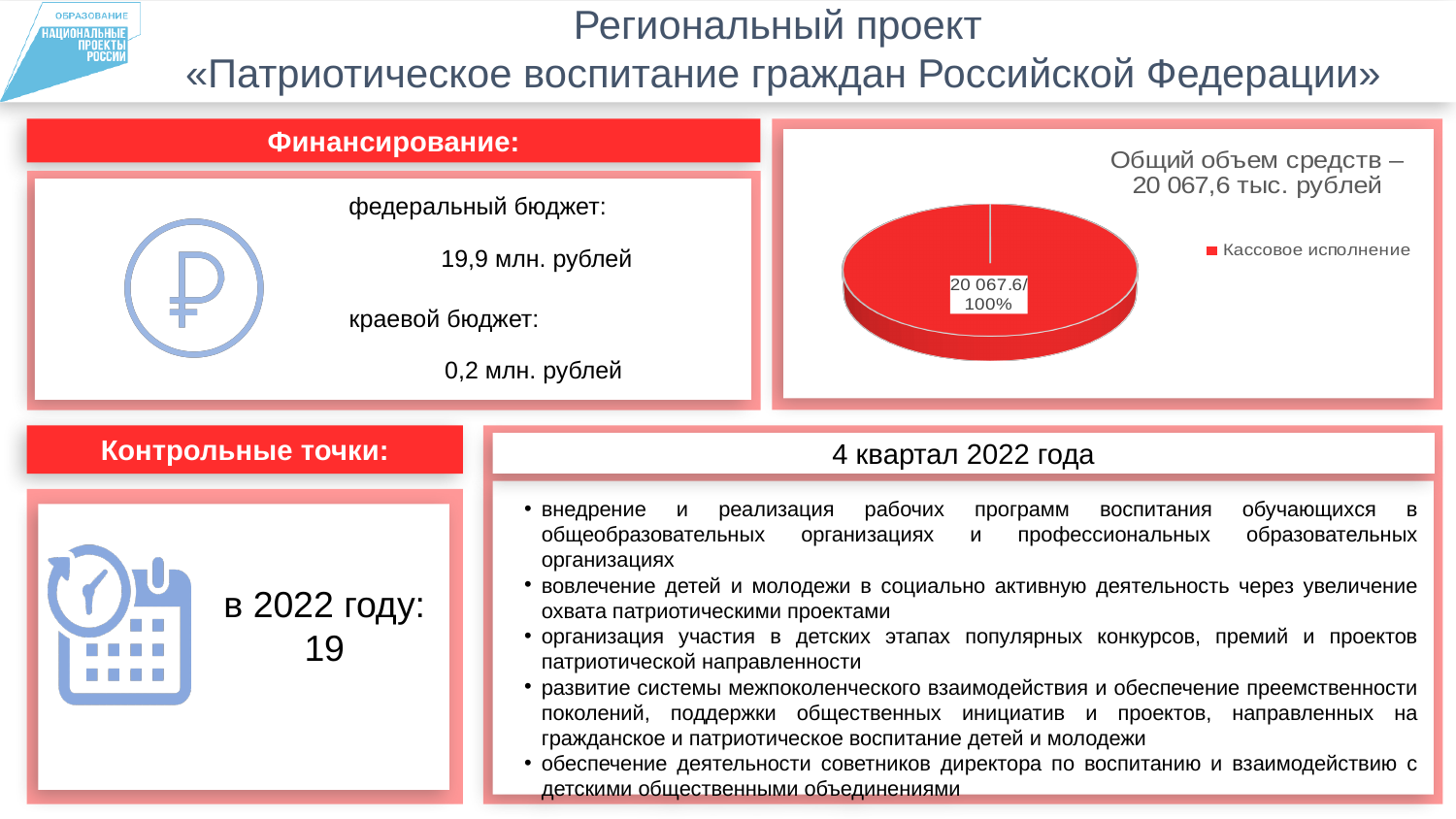
What is the legend entry of the pie chart? Кассовое исполнение What kind of chart is shown on the slide? pie chart Is the value of the slice "Кассовое исполнение" greater or less than 20 000? greater What value is printed on the slice of the pie chart? 20 067.6 How many slices does the pie chart have? 1 How many series does the legend of the pie chart list? 1 What is the title of the pie chart? Общий объем средств – 20 067,6 тыс. рублей What share of the pie does the slice "Кассовое исполнение" represent? 100%